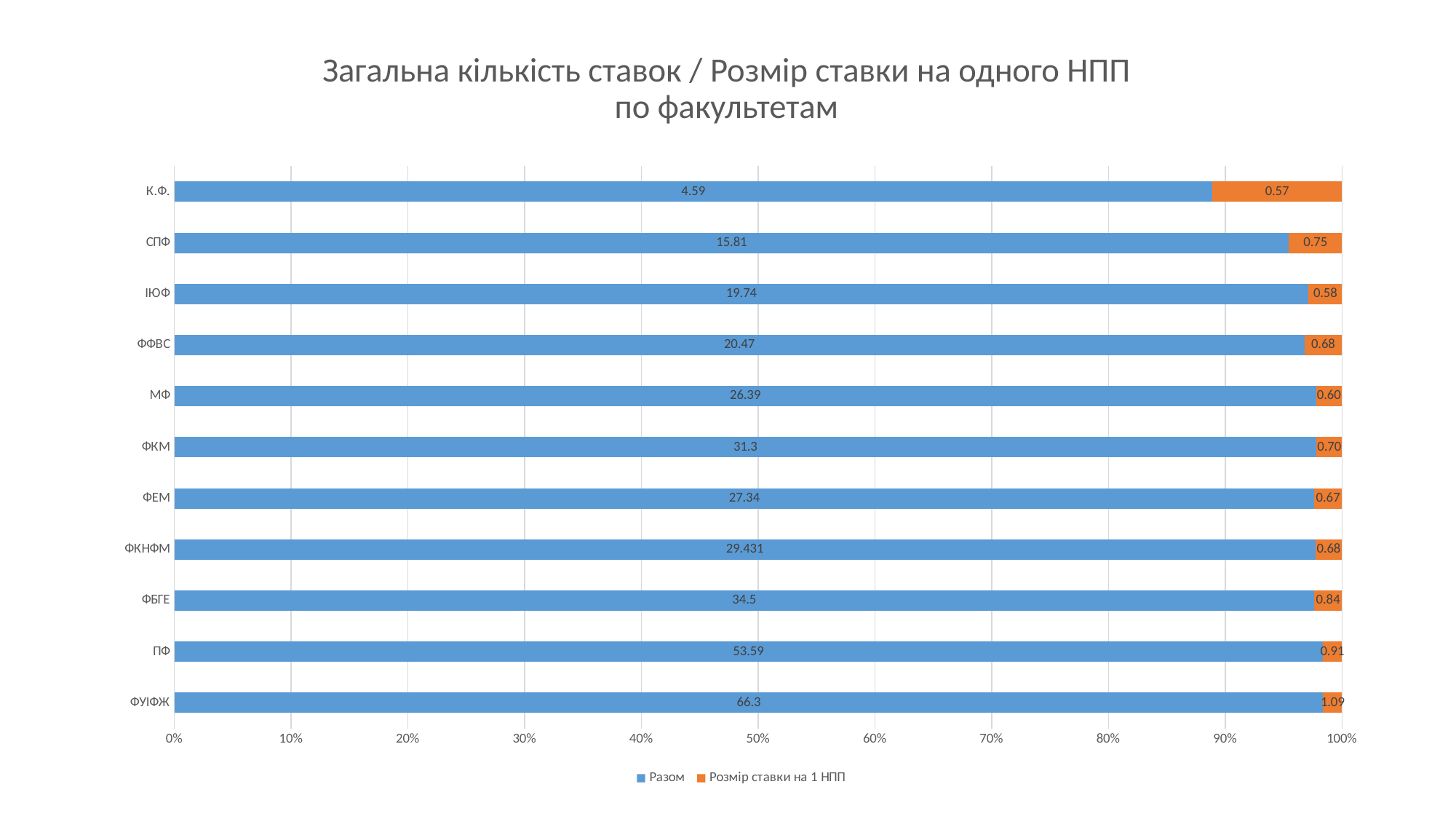
Which has the larger Разом value, ФКМ or ФЕМ? ФКМ What is the Розмір ставки на 1 НПП value for СПФ? 0.75 What is the Разом value for ФКНФМ? 29.431 What is the Разом value for ФУІФЖ? 66.3 How many faculties are shown on the chart? 11 Which faculty has the highest Разом value? ФУІФЖ What is the difference between the Разом values for ПФ and ФБГЕ? 19.09 How many series does the legend list? 2 What kind of chart is shown on the slide? Stacked bar chart Which faculty has the lowest Разом value? К.Ф. What is the Розмір ставки на 1 НПП value for ПФ? 0.91 Which faculty has the highest Розмір ставки на 1 НПП value? ФУІФЖ